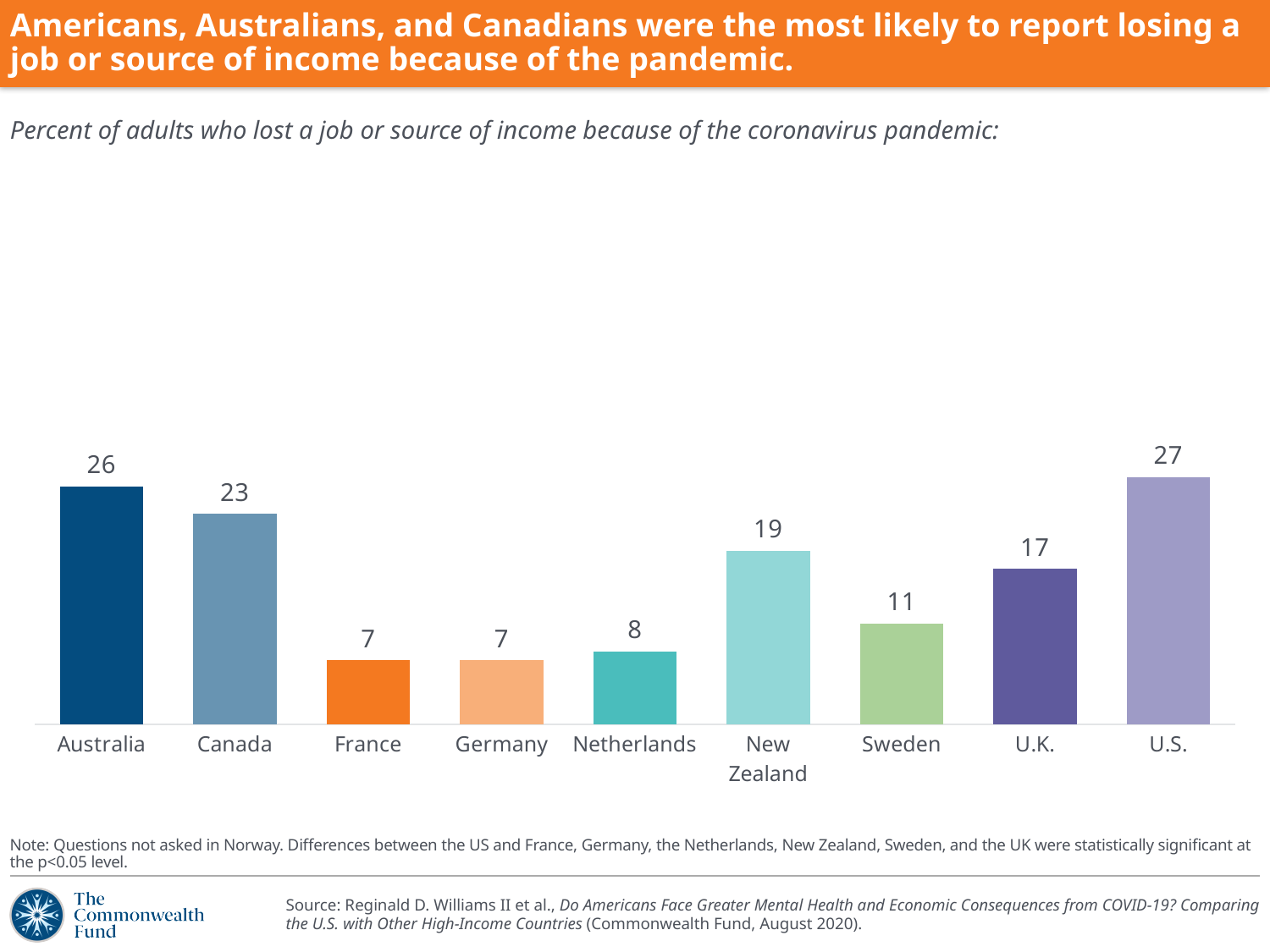
Which country has the highest value? U.S. What is the value for New Zealand? 19 Which countries share the lowest value? France and Germany What is the value for Sweden? 11 What is the difference between the values for Canada and the Netherlands? 15 According to the note, which country was not asked the question? Norway Which is larger, the value for Sweden or the value for the U.K.? U.K. What is the value for Australia? 26 How many countries are shown in the chart? 9 What kind of chart is shown on the slide? Bar chart What is the difference between the values for the U.S. and the U.K.? 10 Which is larger, the value for Canada or the value for New Zealand? Canada